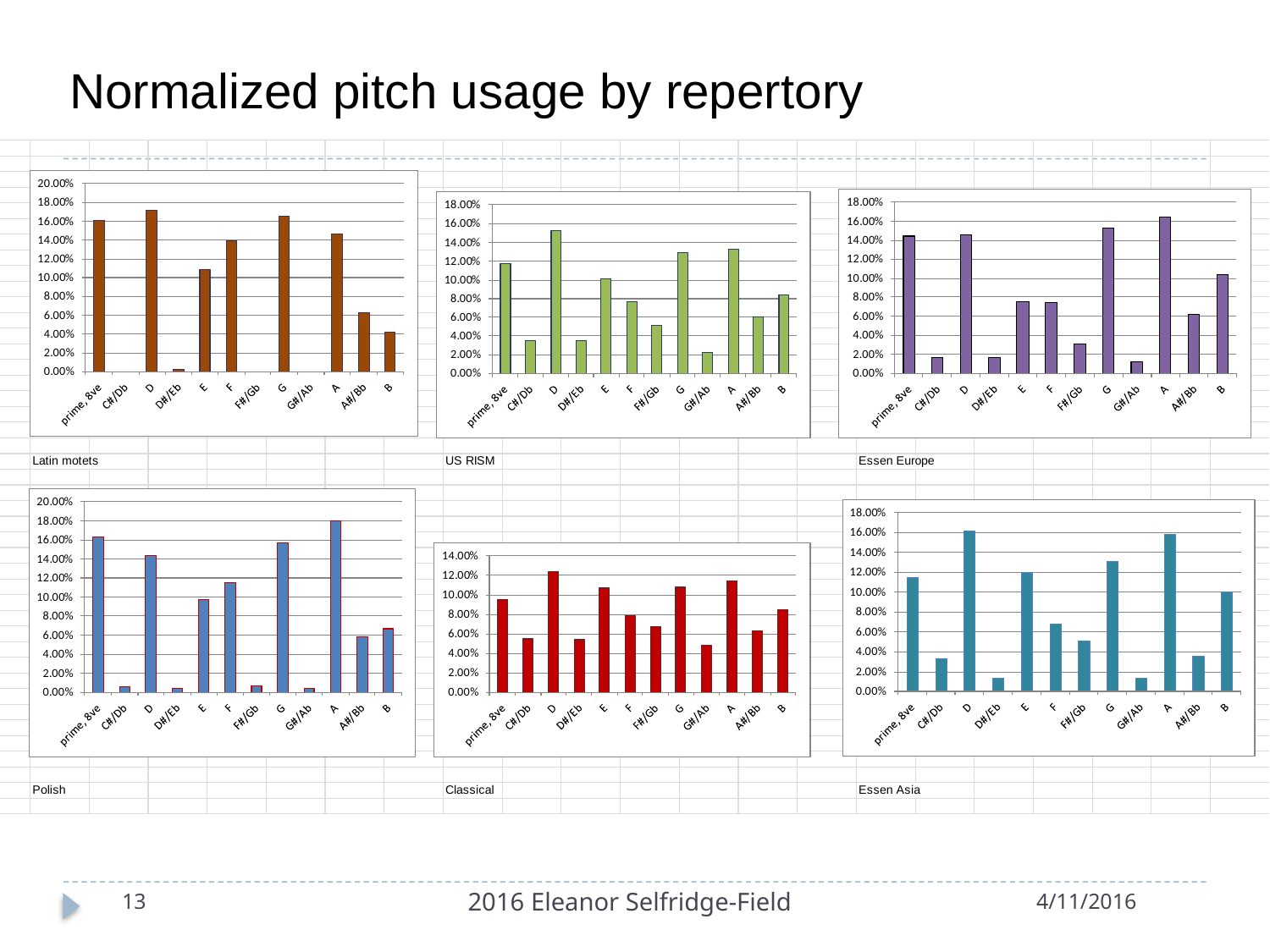
What type of chart is the Classical chart? Bar chart In the Latin motets chart, is the value for E greater or less than 10.00%? greater In the Polish chart, which pitch has the highest value? A In the US RISM chart, which pitch has the lowest value? G#/Ab In the Essen Asia chart, is the value for B greater or less than 8.00%? greater In the Latin motets chart, which pitch has the highest value? D In the Classical chart, which is larger, the value for D or the value for F? D How many pitch categories are shown on the x axis of the Essen Asia chart? 12 In the Polish chart, which is larger, the value for A#/Bb or the value for B? B In the Essen Europe chart, which pitch has the highest value? A In the Classical chart, which pitch has the lowest value? G#/Ab